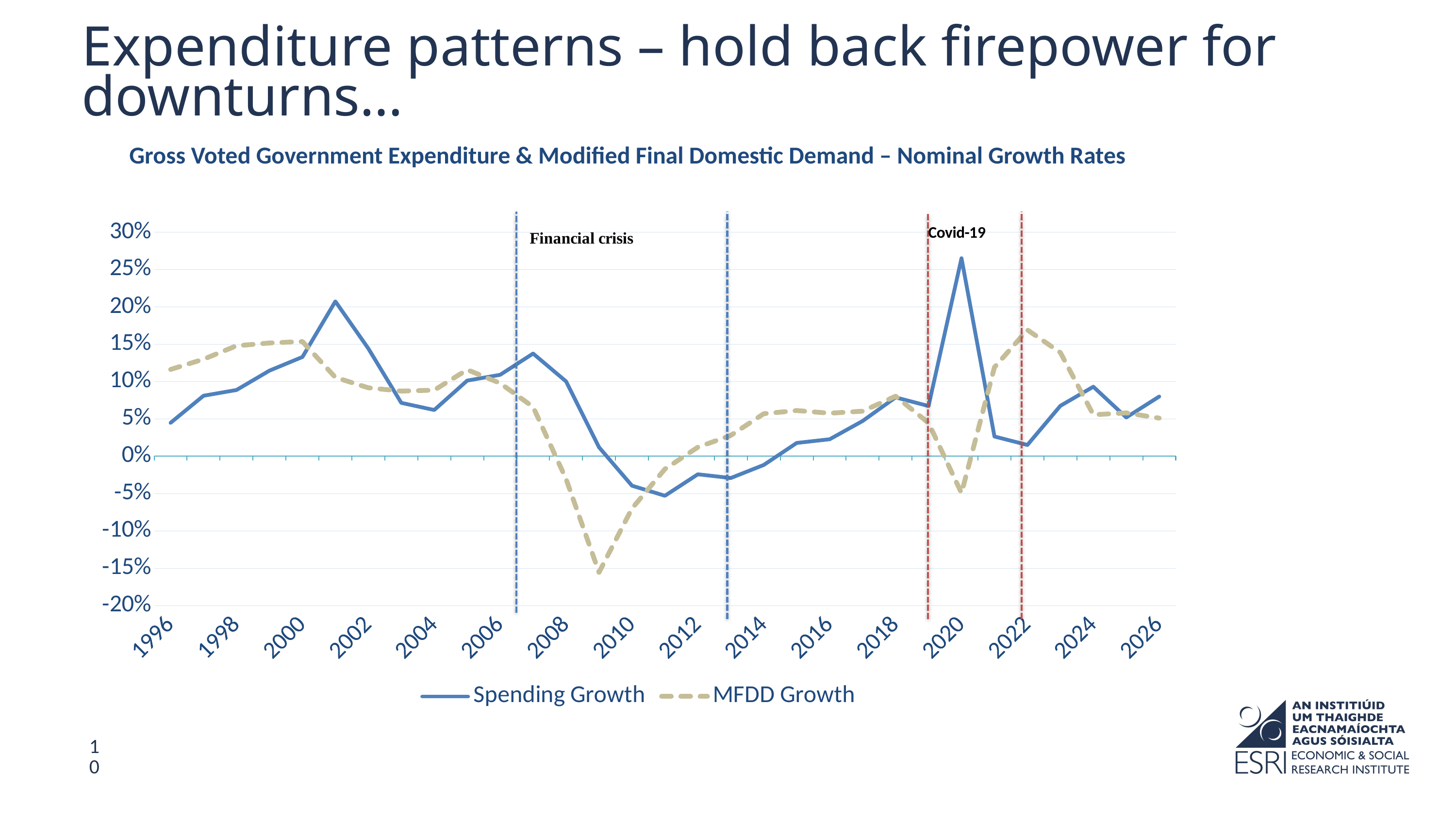
Does Spending Growth rise or fall between 2007 and 2010? fall Is the value for Spending Growth in 2020 greater or less than 20%? greater How many series does the legend list? 2 In 2022, which series is higher, Spending Growth or MFDD Growth? MFDD Growth In which year does Spending Growth reach its highest value? 2020 In which year does MFDD Growth reach its lowest value? 2009 What kind of chart is shown on the slide? line chart In 2020, which series is higher, Spending Growth or MFDD Growth? Spending Growth What are the two series named in the legend? Spending Growth and MFDD Growth Is the value for MFDD Growth in 2009 greater or less than -10%? less Is the value for MFDD Growth in 2020 greater or less than 0%? less What event is labelled between the two blue dashed vertical lines? Financial crisis